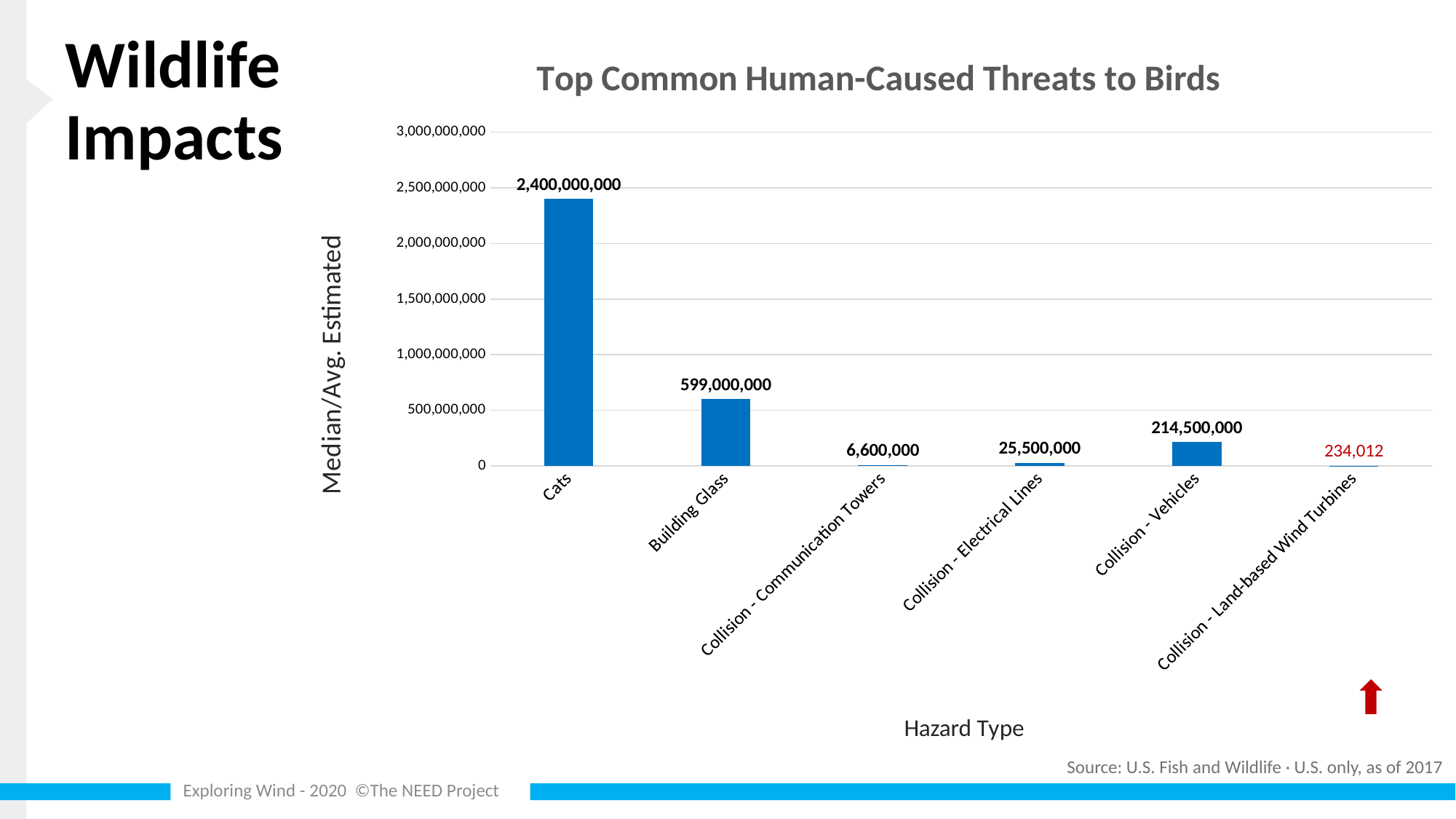
What is the title of the chart? Top Common Human-Caused Threats to Birds How many hazard types are shown on the chart? 6 What is the value for Collision - Land-based Wind Turbines? 234,012 Which hazard type has the highest value? Cats What is the value for Building Glass? 599,000,000 Which hazard type has the lowest value? Collision - Land-based Wind Turbines What kind of chart is shown? bar chart What is the value for Collision - Vehicles? 214,500,000 Which is larger, the value for Collision - Electrical Lines or Collision - Communication Towers? Collision - Electrical Lines Is the value for Building Glass greater or less than 500,000,000? greater What is the difference between the values for Cats and Building Glass? 1,801,000,000 What is the value for Cats? 2,400,000,000